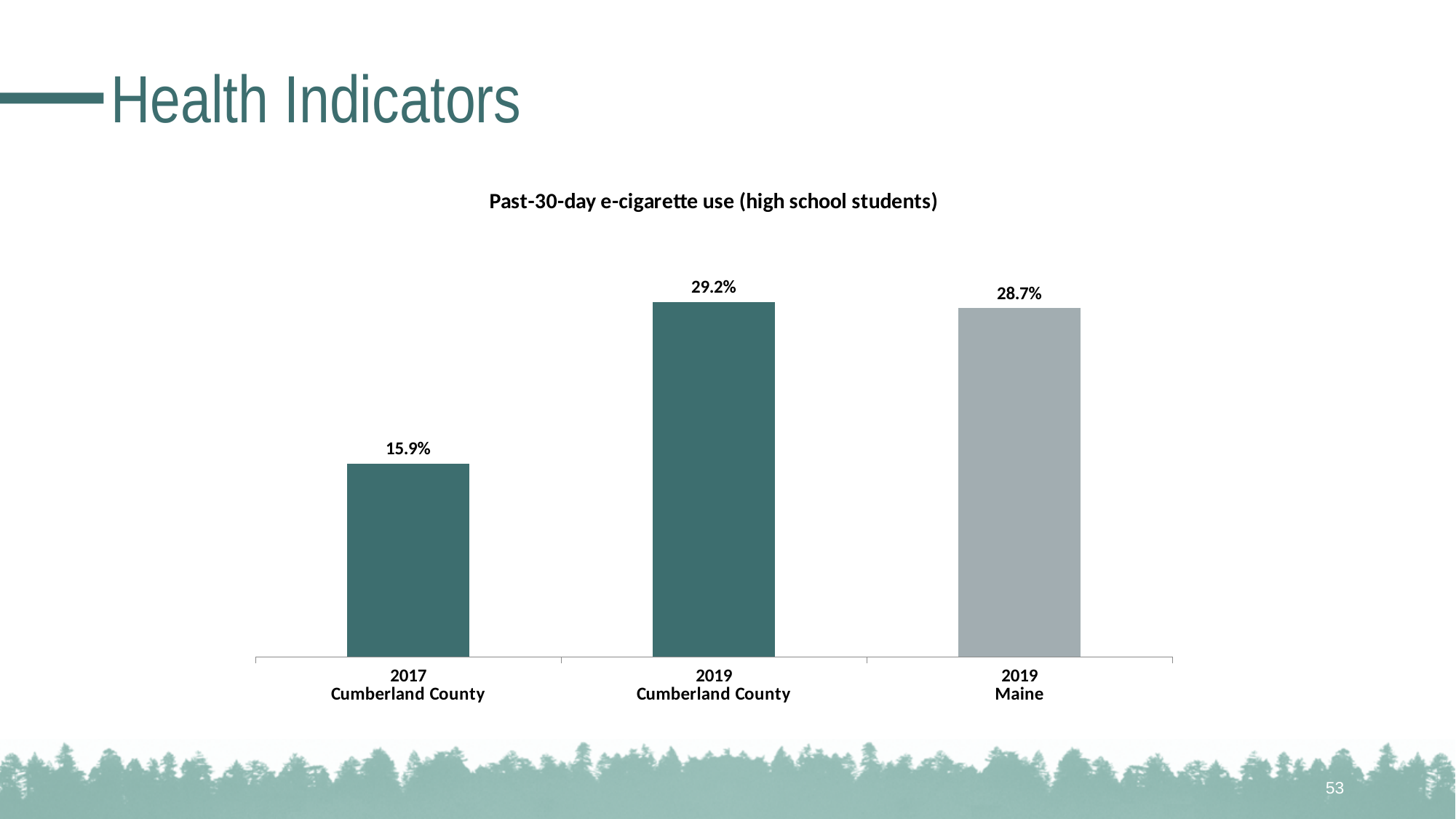
What is the past-30-day e-cigarette use value for 2019 Maine? 28.7% What is the past-30-day e-cigarette use value for 2019 Cumberland County? 29.2% Which is larger: the value for 2017 Cumberland County or the value for 2019 Maine? 2019 Maine What is the difference between the 2019 Cumberland County value and the 2019 Maine value? 0.5% What is the difference between the 2019 Cumberland County value and the 2017 Cumberland County value? 13.3% How many bars are shown in the chart? 3 What is the past-30-day e-cigarette use value for 2017 Cumberland County? 15.9% Which category has the highest value in the chart? 2019 Cumberland County What is the title of the chart? Past-30-day e-cigarette use (high school students) What kind of chart is shown on the slide? Bar chart Did past-30-day e-cigarette use in Cumberland County rise or fall from 2017 to 2019? Rise Which category has the lowest value in the chart? 2017 Cumberland County